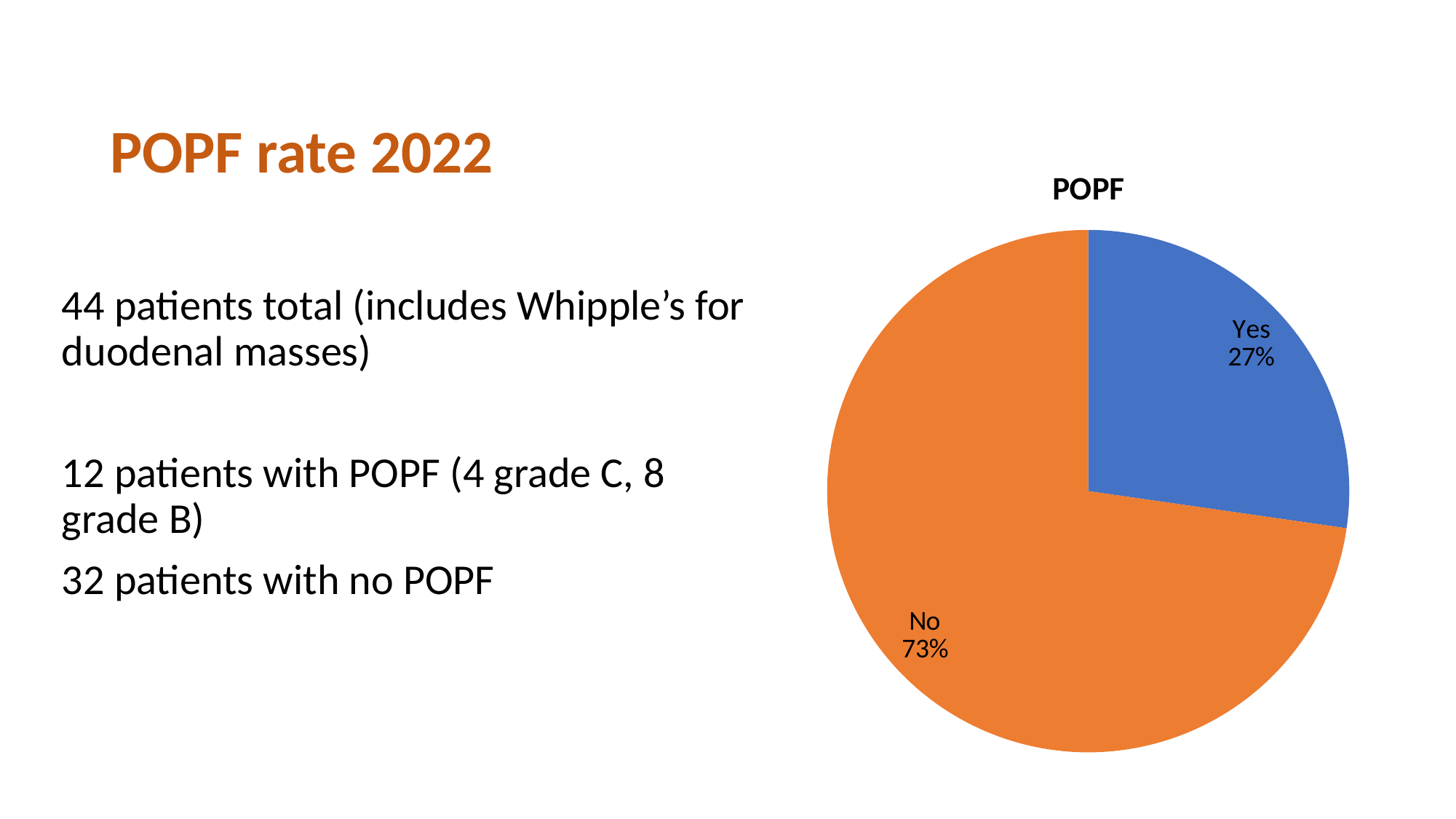
What share of the pie does the "No" slice represent? 73% What is the difference in percentage points between the "No" slice and the "Yes" slice? 46% What kind of chart is shown on the slide? pie chart What colour is the "Yes" slice? blue Is the share of the "Yes" slice greater or less than 50%? less What share of the pie does the "Yes" slice represent? 27% Which slice of the pie is the smallest? Yes Which slice of the pie is the largest? No What is the title of the chart? POPF How many slices does the pie chart have? 2 Which is larger, the "Yes" slice or the "No" slice? No